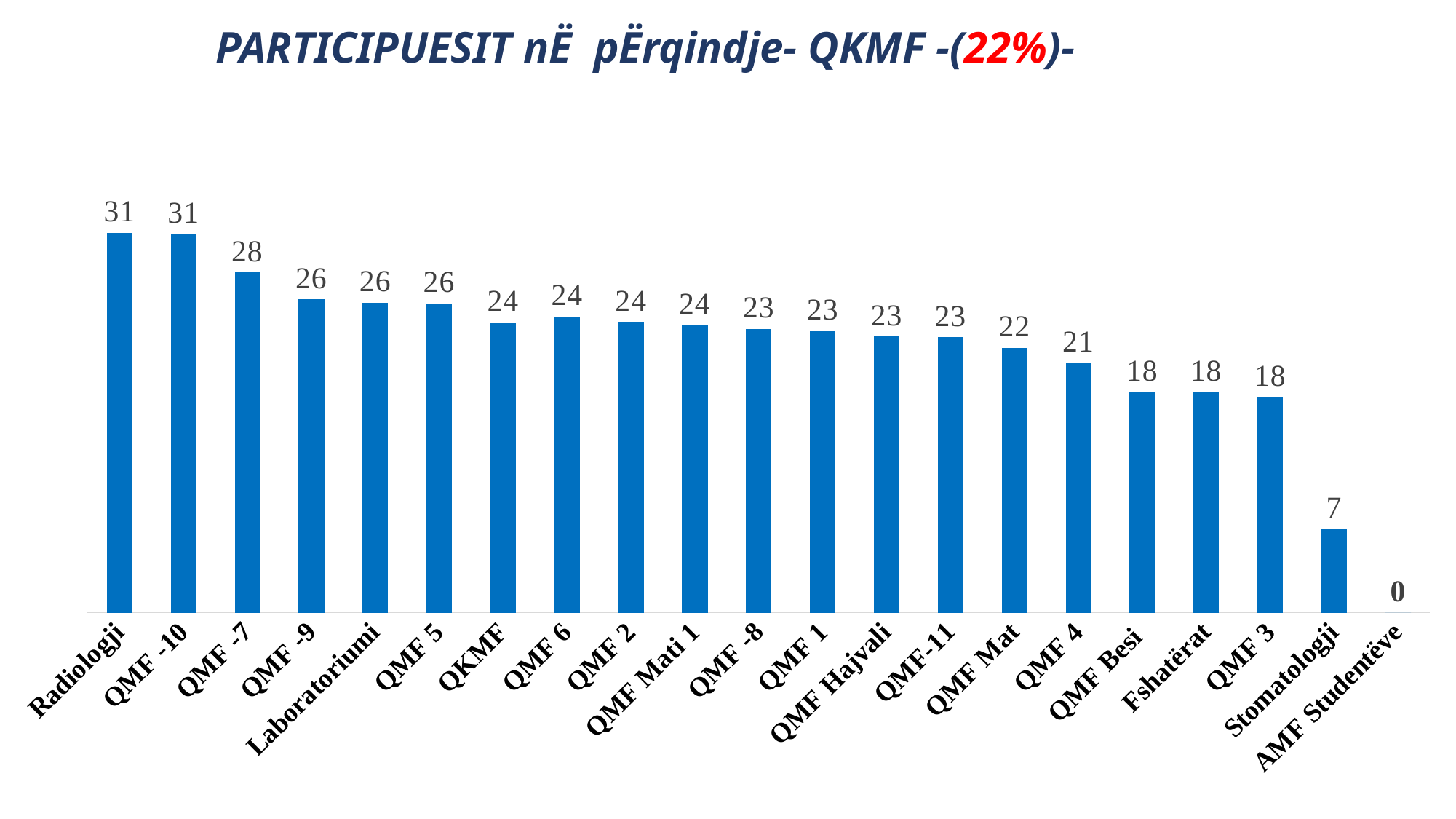
What is the difference between the values for Radiologji and Stomatologji? 24 Which is larger, the value for QMF Mat or the value for QMF Besi? QMF Mat What is the value for Laboratoriumi? 26 What is the value for Stomatologji? 7 What is the value for QMF Hajvali? 23 What percentage is shown in red in the chart title? 22% What is the value for Radiologji? 31 Which category has the lowest value? AMF Studentëve What is the difference between the values for QMF -7 and QMF 3? 10 What is the value for QMF -7? 28 How many categories are shown on the chart? 21 What kind of chart is shown on the slide? Bar chart